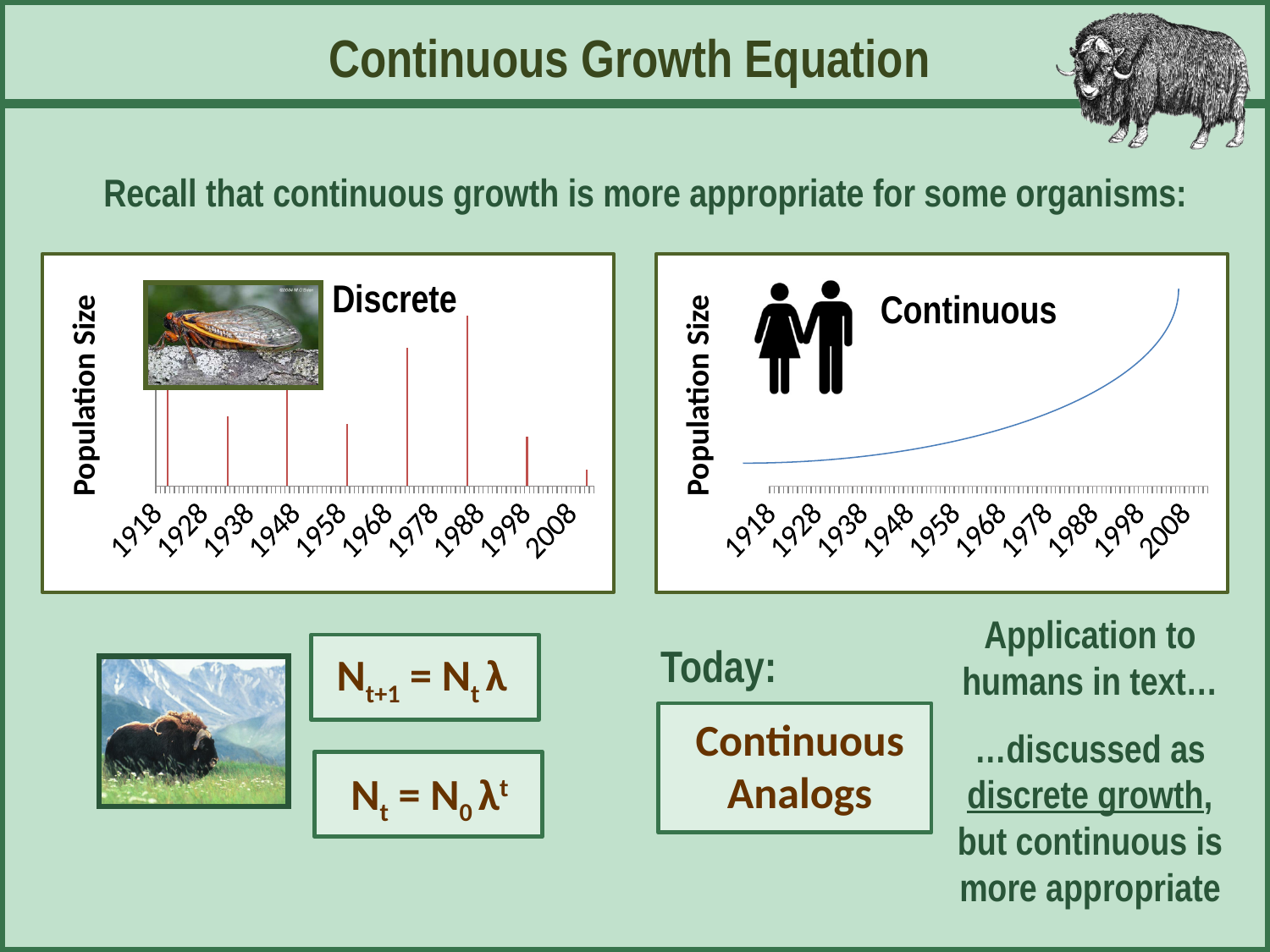
How many year labels are shown on the x axis of the Continuous chart? 10 What is the y-axis label of the Discrete chart? Population Size In the Discrete chart, is the last bar taller or shorter than the first bar? shorter What kind of chart is the Discrete chart on the left? bar chart How many years apart are consecutive x-axis labels on the Discrete chart? 10 What is the last year label on the x axis of the Discrete chart? 2008 How many bars are plotted in the Discrete chart? 8 In the Continuous chart, do the values rise or fall from 1918 to 2008? rise In the Discrete chart, is the tallest bar located before or after 1968 on the x axis? after What kind of chart is the Continuous chart on the right? line chart Which of the two charts shows a smooth, continuously increasing curve? Continuous What is the first year label on the x axis of the Continuous chart? 1918